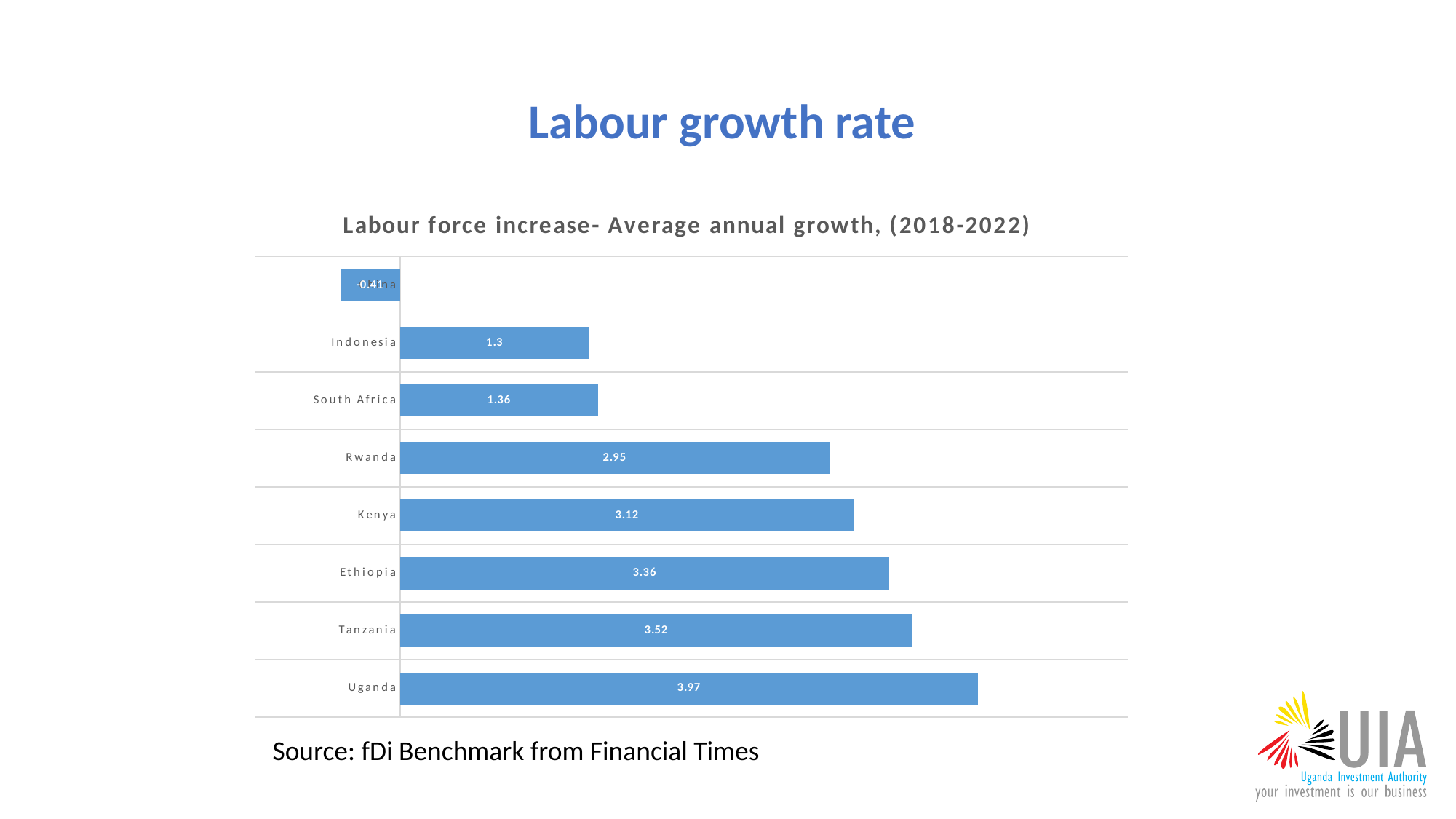
Which country has the highest labour force average annual growth? Uganda What is the difference between the values for Uganda and Tanzania? 0.45 What is the labour force average annual growth value for Uganda? 3.97 Which has a larger value, Kenya or South Africa? Kenya Which has a larger value, Ethiopia or Rwanda? Ethiopia What is the value shown for Tanzania? 3.52 What is the value shown for Indonesia? 1.3 What is the title of the chart? Labour force increase- Average annual growth, (2018-2022) What is the difference between the values for South Africa and Indonesia? 0.06 How many bars are plotted in the chart? 8 What kind of chart is shown on the slide? Bar chart What is the value shown for Kenya? 3.12